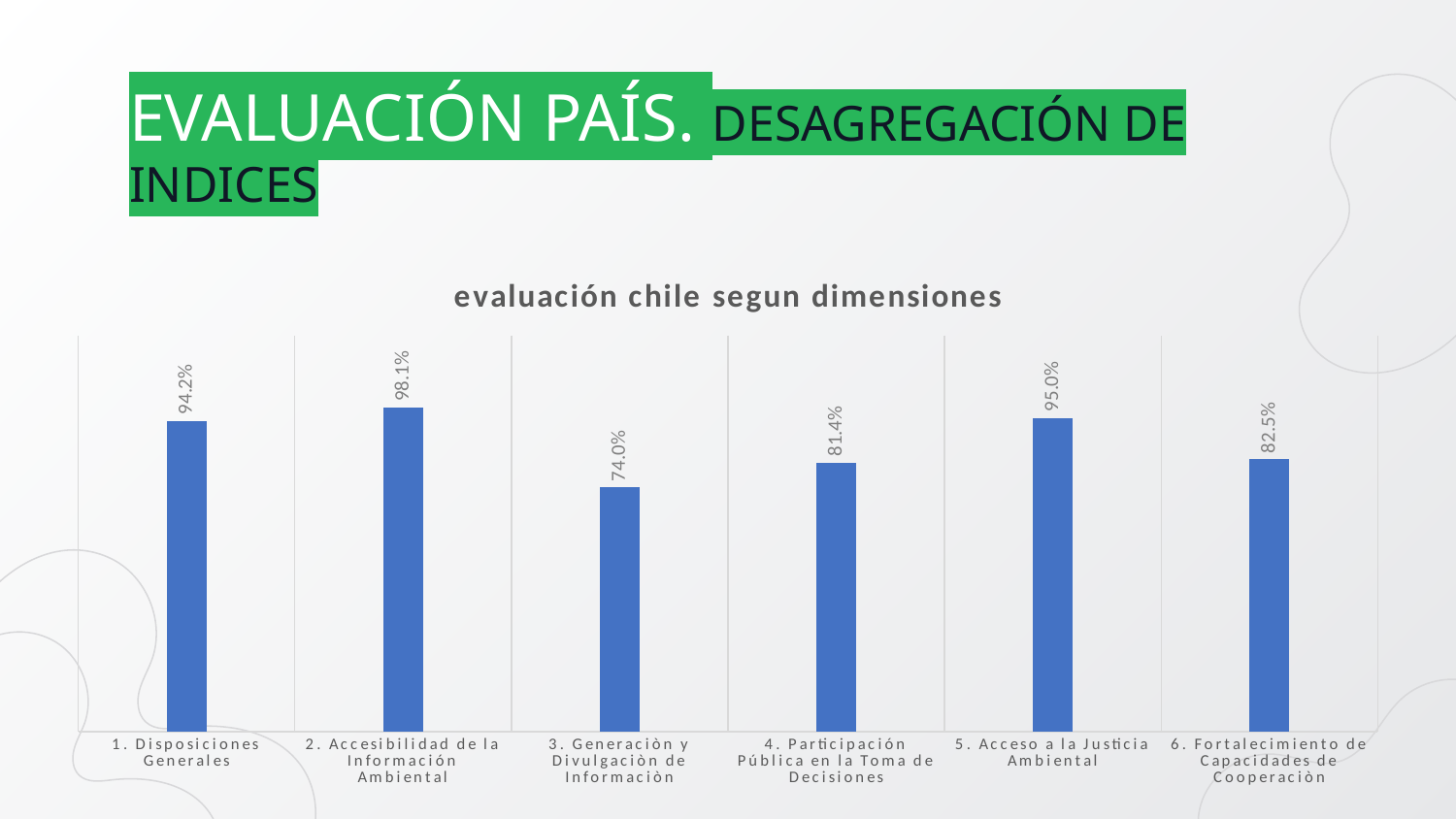
What kind of chart is shown on the slide? Bar chart What is the title of the chart? evaluación chile segun dimensiones What is the difference between the values for 2. Accesibilidad de la Información Ambiental and 3. Generaciòn y Divulgaciòn de Informaciòn? 24.1% Which is larger, the value for 1. Disposiciones Generales or the value for 5. Acceso a la Justicia Ambiental? 5. Acceso a la Justicia Ambiental What is the difference between the values for 6. Fortalecimiento de Capacidades de Cooperaciòn and 4. Participación Pública en la Toma de Decisiones? 1.1% How many categories are shown in the chart? 6 What is the value for 5. Acceso a la Justicia Ambiental? 95.0% What is the value for 1. Disposiciones Generales? 94.2% Which category has the lowest value? 3. Generaciòn y Divulgaciòn de Informaciòn Which is larger, the value for 4. Participación Pública en la Toma de Decisiones or the value for 6. Fortalecimiento de Capacidades de Cooperaciòn? 6. Fortalecimiento de Capacidades de Cooperaciòn What is the value for 3. Generaciòn y Divulgaciòn de Informaciòn? 74.0% Which category has the highest value? 2. Accesibilidad de la Información Ambiental